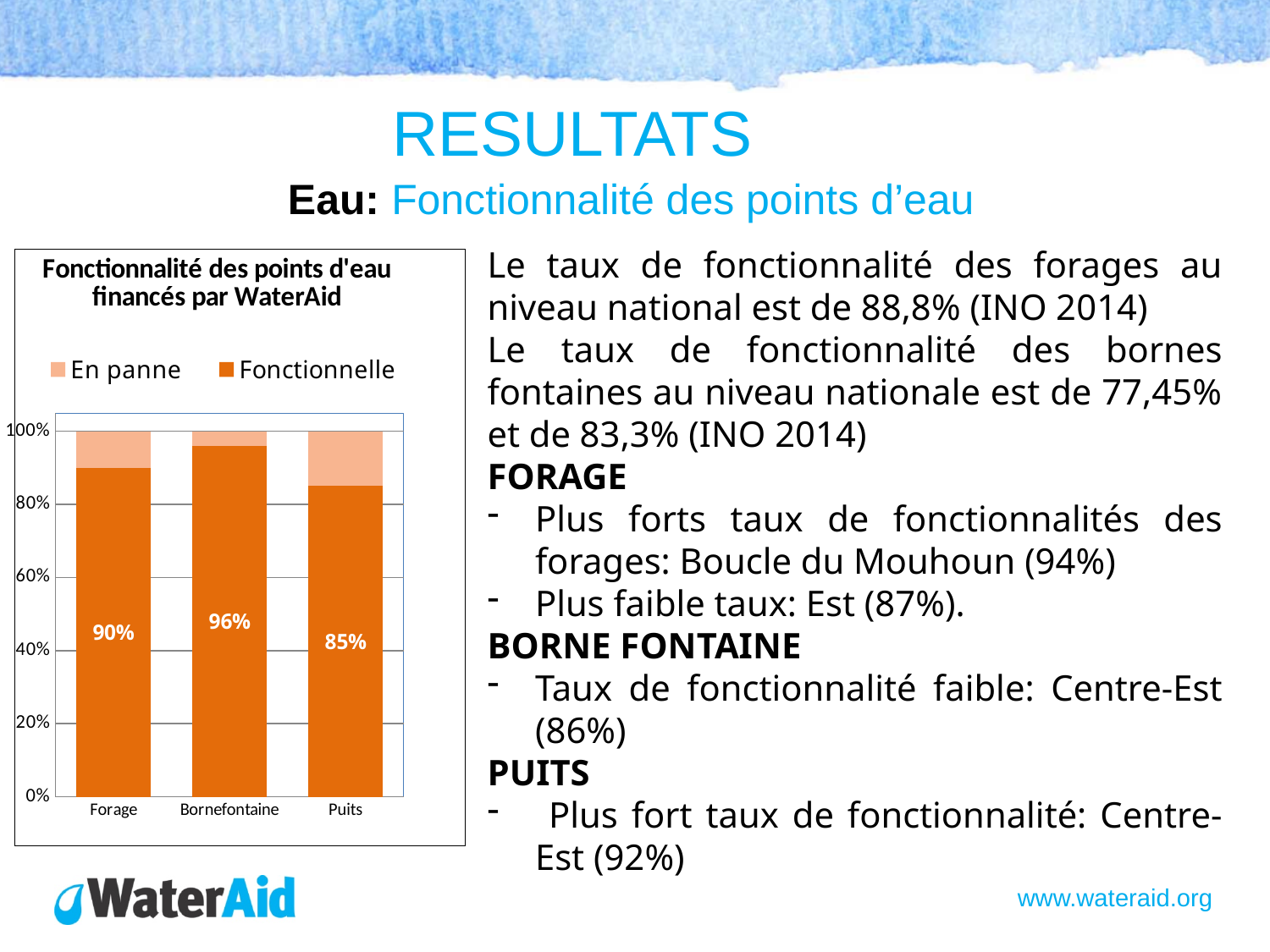
How many series does the legend list? 2 What kind of chart is shown on the slide? Stacked bar chart What is the Fonctionnelle value for Forage? 90% What is the difference between the Fonctionnelle values for Bornefontaine and Puits? 11% How many categories are shown on the x axis? 3 What is the title of the chart? Fonctionnalité des points d'eau financés par WaterAid Which category has the lowest Fonctionnelle value? Puits Which has a larger Fonctionnelle value, Forage or Puits? Forage What is the Fonctionnelle value for Puits? 85% Is the Fonctionnelle value for Puits greater or less than 80%? greater What is the Fonctionnelle value for Bornefontaine? 96% Which category has the highest Fonctionnelle value? Bornefontaine